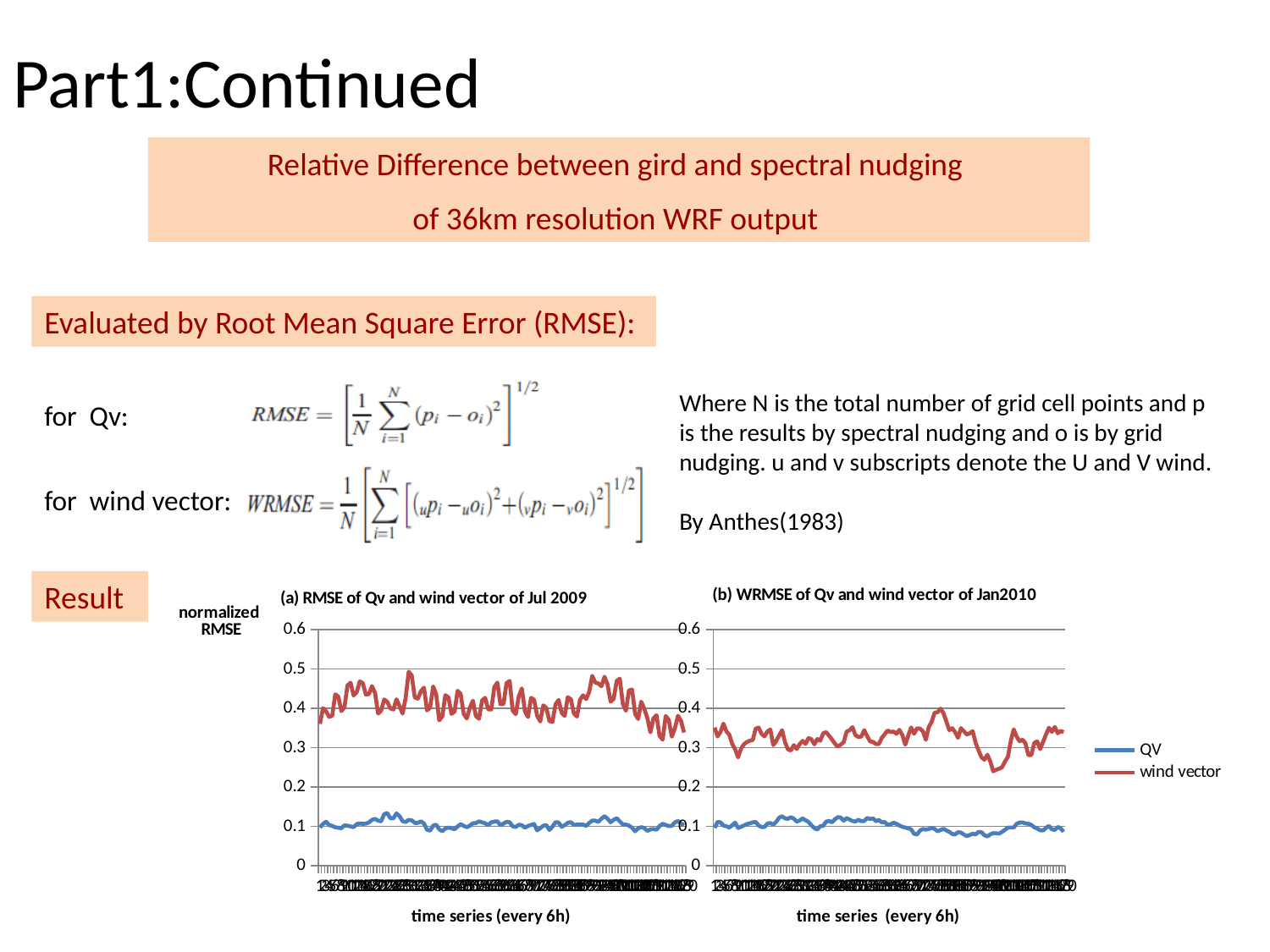
What is the x-axis label of the chart titled "(a) RMSE of Qv and wind vector of Jul 2009"? time series (every 6h) In the chart titled "(b) WRMSE of Qv and wind vector of Jan2010", are the values for wind vector greater or less than 0.2? greater In the chart titled "(b) WRMSE of Qv and wind vector of Jan2010", which series has the lower values, QV or wind vector? QV In the chart titled "(b) WRMSE of Qv and wind vector of Jan2010", are the values for QV greater or less than 0.2? less What are the two series named in the legend of the charts? QV and wind vector How many series does the legend list for the charts on the slide? 2 In the chart titled "(a) RMSE of Qv and wind vector of Jul 2009", which series has the higher values, QV or wind vector? wind vector In the chart titled "(b) WRMSE of Qv and wind vector of Jan2010", are the values for wind vector greater or less than 0.5? less What is the title of the right-hand chart? (b) WRMSE of Qv and wind vector of Jan2010 What kind of chart is the chart titled "(a) RMSE of Qv and wind vector of Jul 2009"? line chart